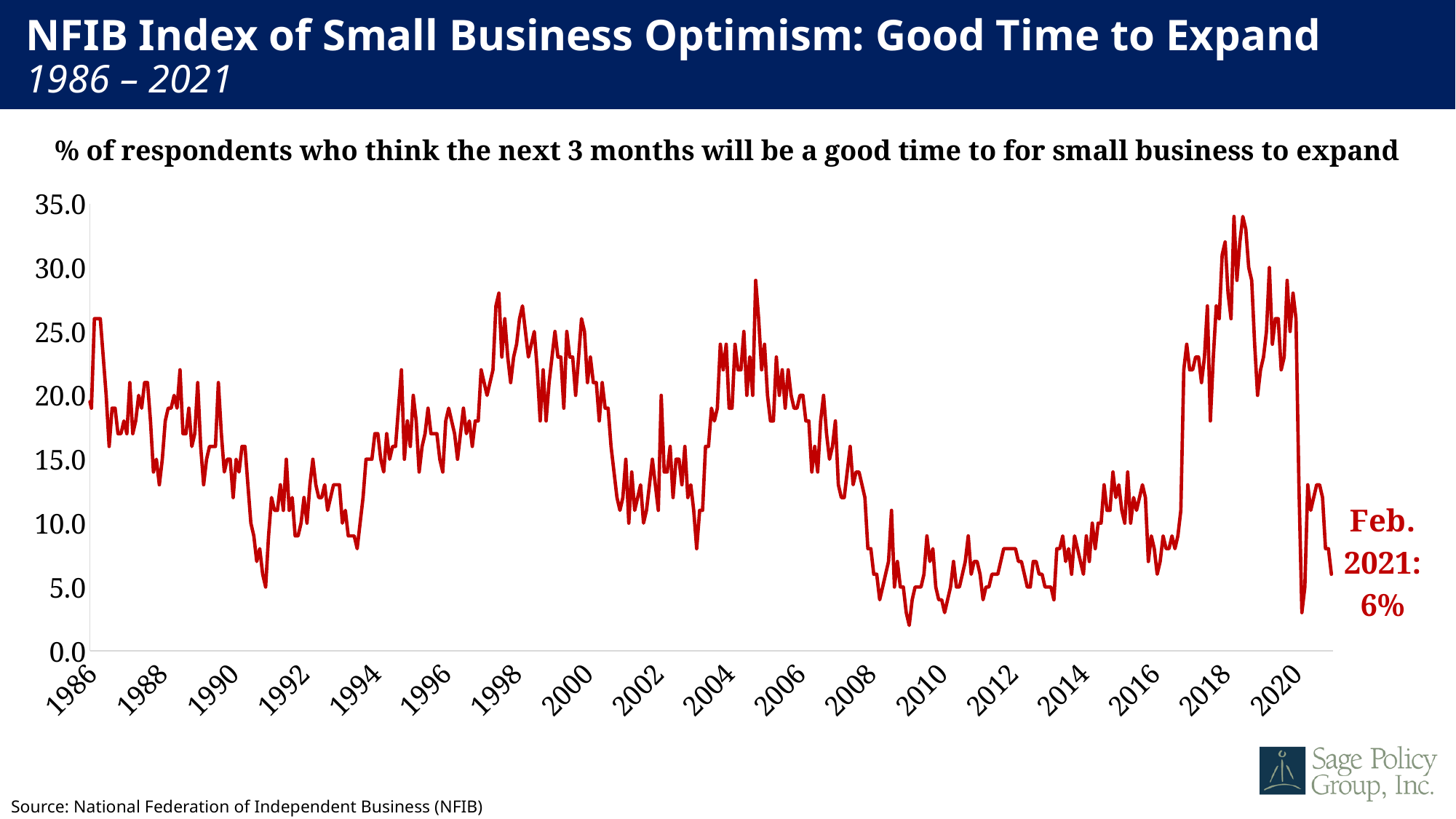
What kind of chart is shown on the slide? line chart How many lines are plotted on the chart? 1 How many year labels are shown on the x-axis? 18 Between 2016 and 2018, does the line generally rise or fall? rise Is the value around 2012 greater or less than 10.0? less Is the lowest value reached by the line (around 2009) greater or less than 5.0? less What value is labeled for Feb. 2021 on the chart? 6% Is the value at the start of the series in 1986 greater or less than 15.0? greater From its peak around 2018 to early 2021, does the line rise or fall? fall What is the source cited for the chart? National Federation of Independent Business (NFIB) Which is higher, the value around 2018 or the value around 2009? 2018